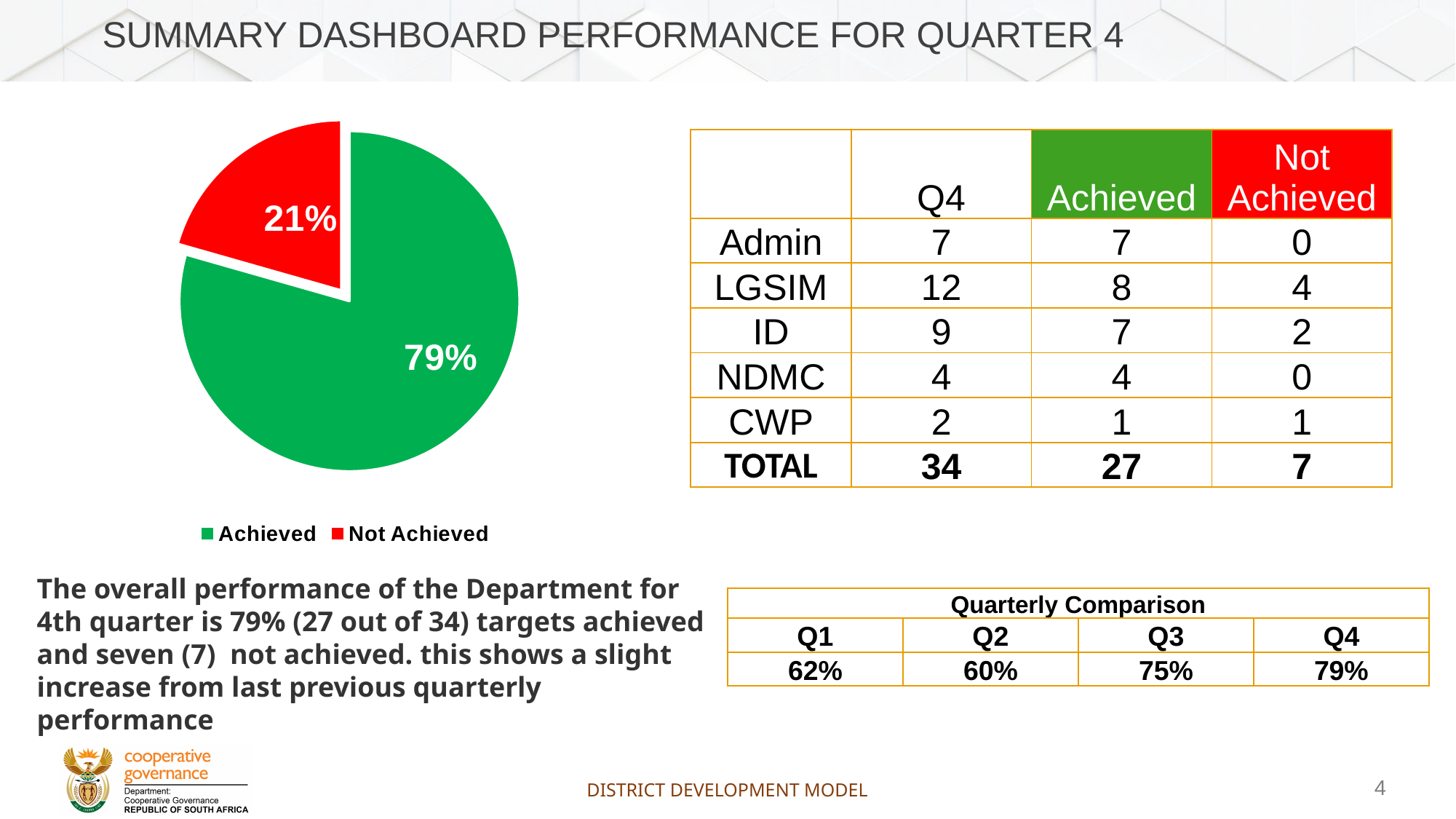
Which is larger in the pie chart, Achieved or Not Achieved? Achieved How many entries does the pie chart's legend list? 2 Which slice of the pie chart is the smallest? Not Achieved What colour is the Achieved slice in the pie chart? green Which slice of the pie chart is the largest? Achieved How many slices does the pie chart have? 2 What colour is the Not Achieved slice in the pie chart? red What is the difference in percentage points between the Achieved and Not Achieved slices of the pie chart? 58 What percentage of the pie chart is labelled Not Achieved? 21% Is the Achieved slice of the pie chart greater or less than 50%? greater What percentage of the pie chart is labelled Achieved? 79% What type of chart is shown on the slide? pie chart